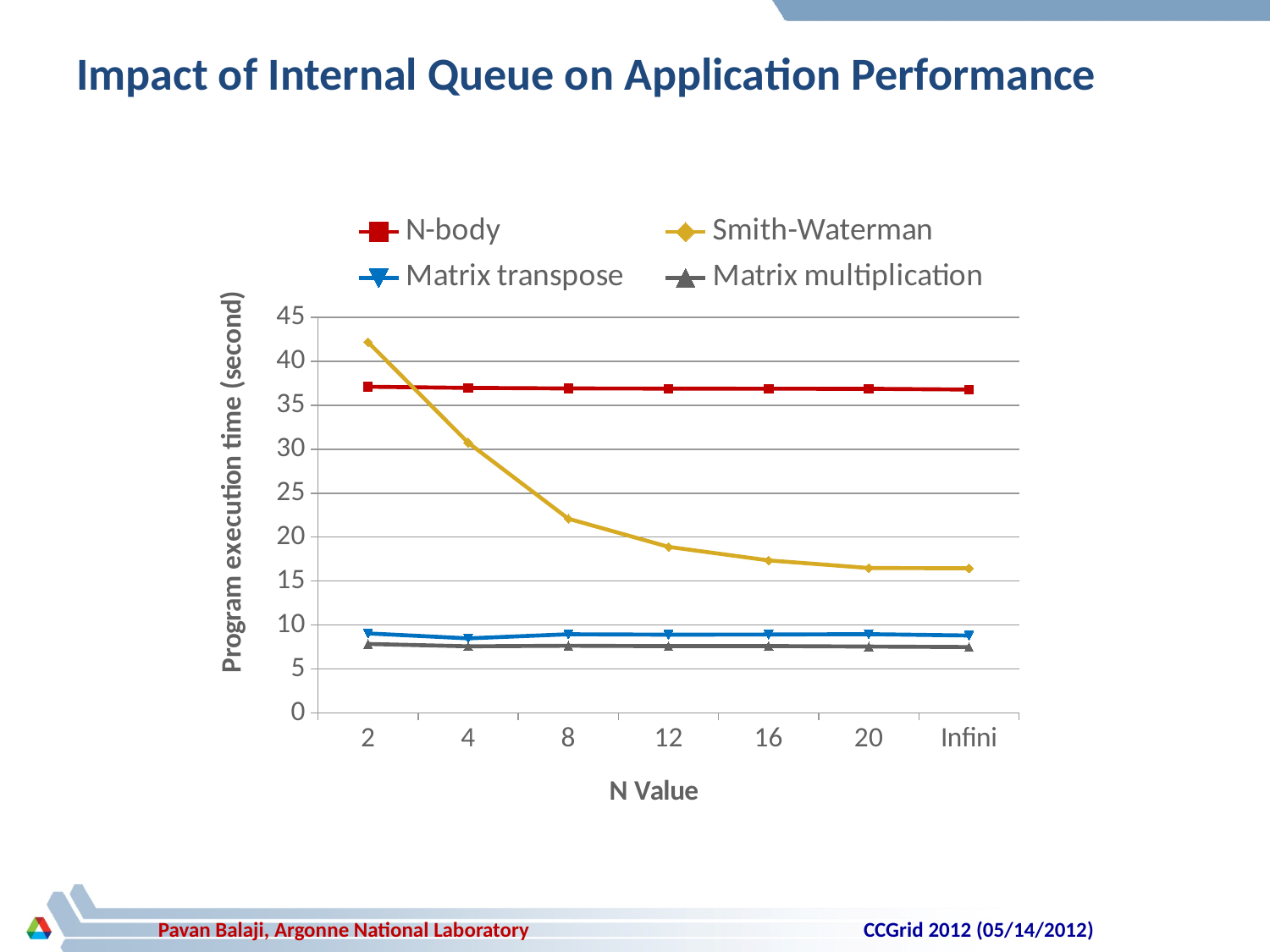
How many N Value categories are shown on the x axis? 7 Which series has the lowest execution time at N Value 2? Matrix multiplication Is the Smith-Waterman value at N Value 8 greater or less than 25? less Which series has the highest execution time at N Value Infini? N-body How many series does the legend list? 4 At N Value 8, which is larger: N-body or Smith-Waterman? N-body Is the N-body value at N Value 2 greater or less than 35? greater What kind of chart is shown on the slide? line chart What is the title of the y axis? Program execution time (second) At N Value 2, which is larger: Smith-Waterman or N-body? Smith-Waterman Is the Smith-Waterman value at N Value 2 greater or less than 40? greater Does the Smith-Waterman execution time rise or fall as the N Value increases? fall